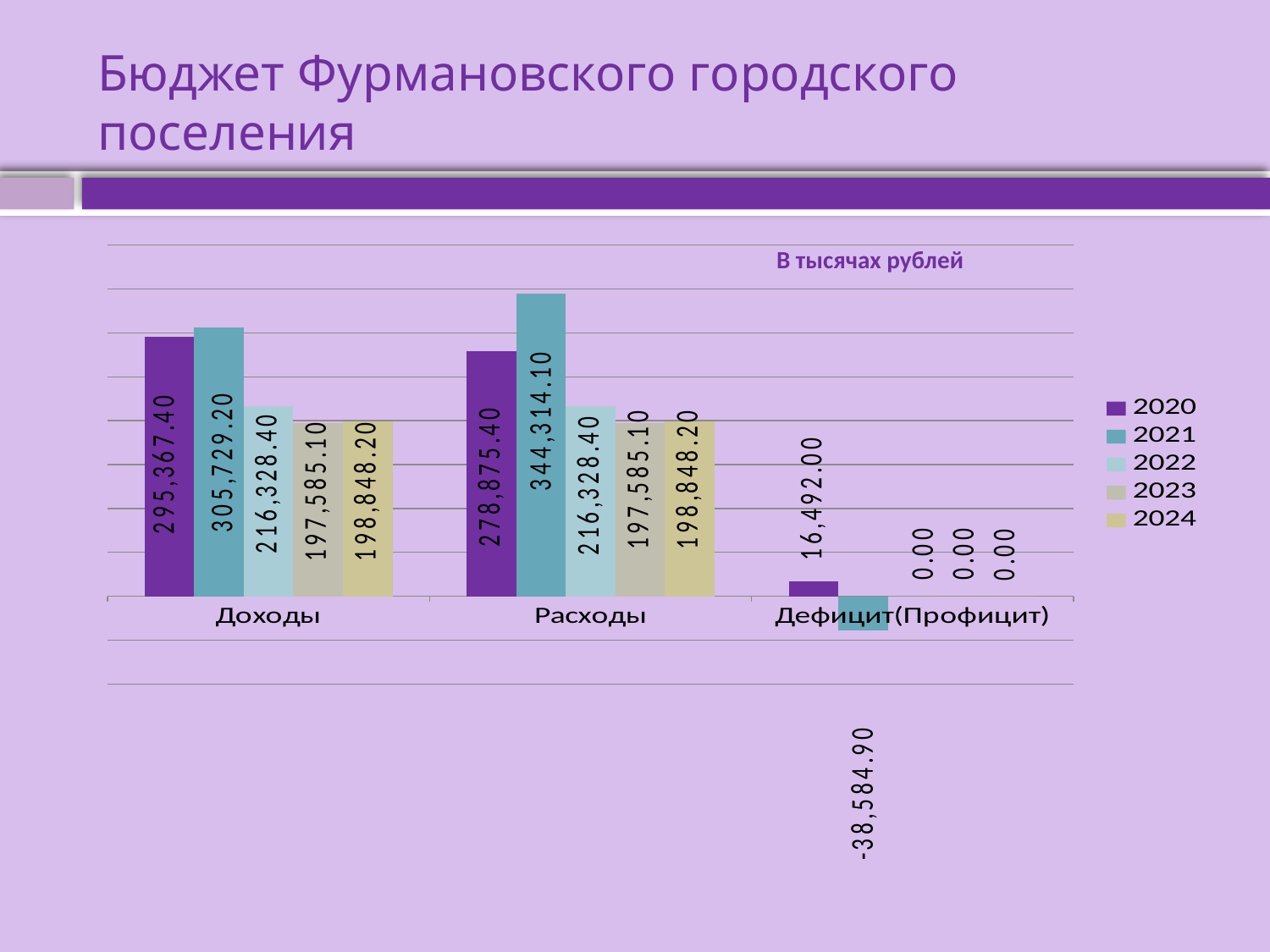
What is the value for Доходы in 2021? 305,729.20 What is the difference between Расходы and Доходы in 2021? 38,584.90 What is the value for Доходы in 2023? 197,585.10 Which year has the lowest value for Доходы? 2023 What is the difference between Доходы in 2021 and Доходы in 2020? 10,361.80 Which year has the highest value for Расходы? 2021 What is the value for Дефицит(Профицит) in 2020? 16,492.00 What kind of chart is shown on the slide? Bar chart What is the value for Расходы in 2021? 344,314.10 What is the value for Дефицит(Профицит) in 2021? -38,584.90 Which is larger in 2020: Доходы or Расходы? Доходы How many series does the legend list? 5